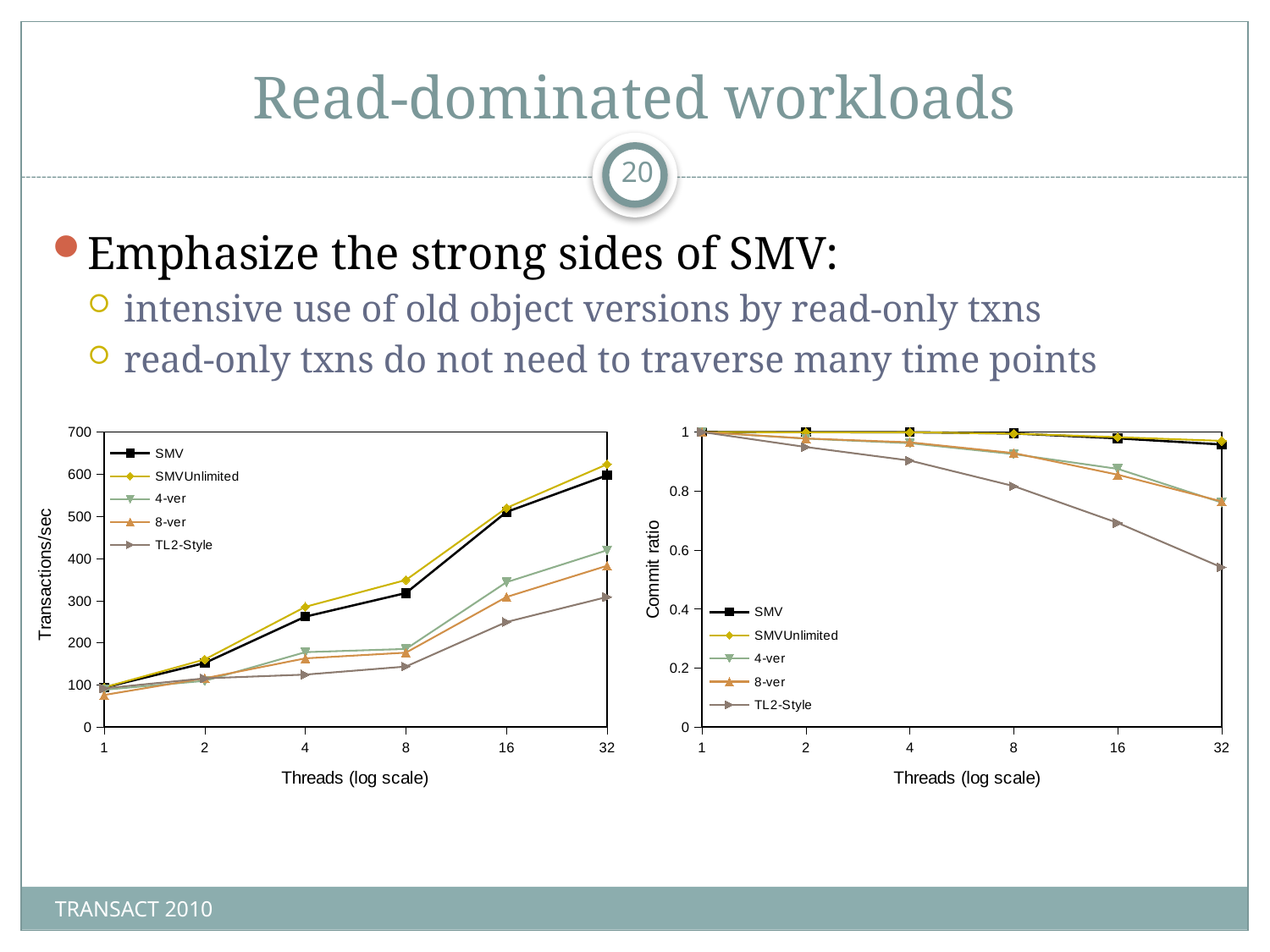
In the left chart (Transactions/sec), is the value for SMVUnlimited at 32 threads greater or less than 500? greater How many series does the legend of the left chart (Transactions/sec) list? 5 In the right chart (Commit ratio), does the TL2-Style series rise or fall as the number of threads increases? fall In the right chart (Commit ratio), which series has the lowest value at 32 threads? TL2-Style In the left chart (Transactions/sec), is the value for TL2-Style at 32 threads greater or less than 400? less What is the y-axis title of the right chart? Commit ratio What kind of chart is the left chart (Transactions/sec)? line chart In the left chart (Transactions/sec), at 16 threads, which is larger: 4-ver or TL2-Style? 4-ver In the left chart (Transactions/sec), does the SMV series rise or fall as the number of threads increases? rise In the right chart (Commit ratio), is the value for TL2-Style at 16 threads greater or less than 0.8? less In the left chart (Transactions/sec), which series has the lowest value at 32 threads? TL2-Style How many thread counts are plotted along the x axis of the right chart (Commit ratio)? 6